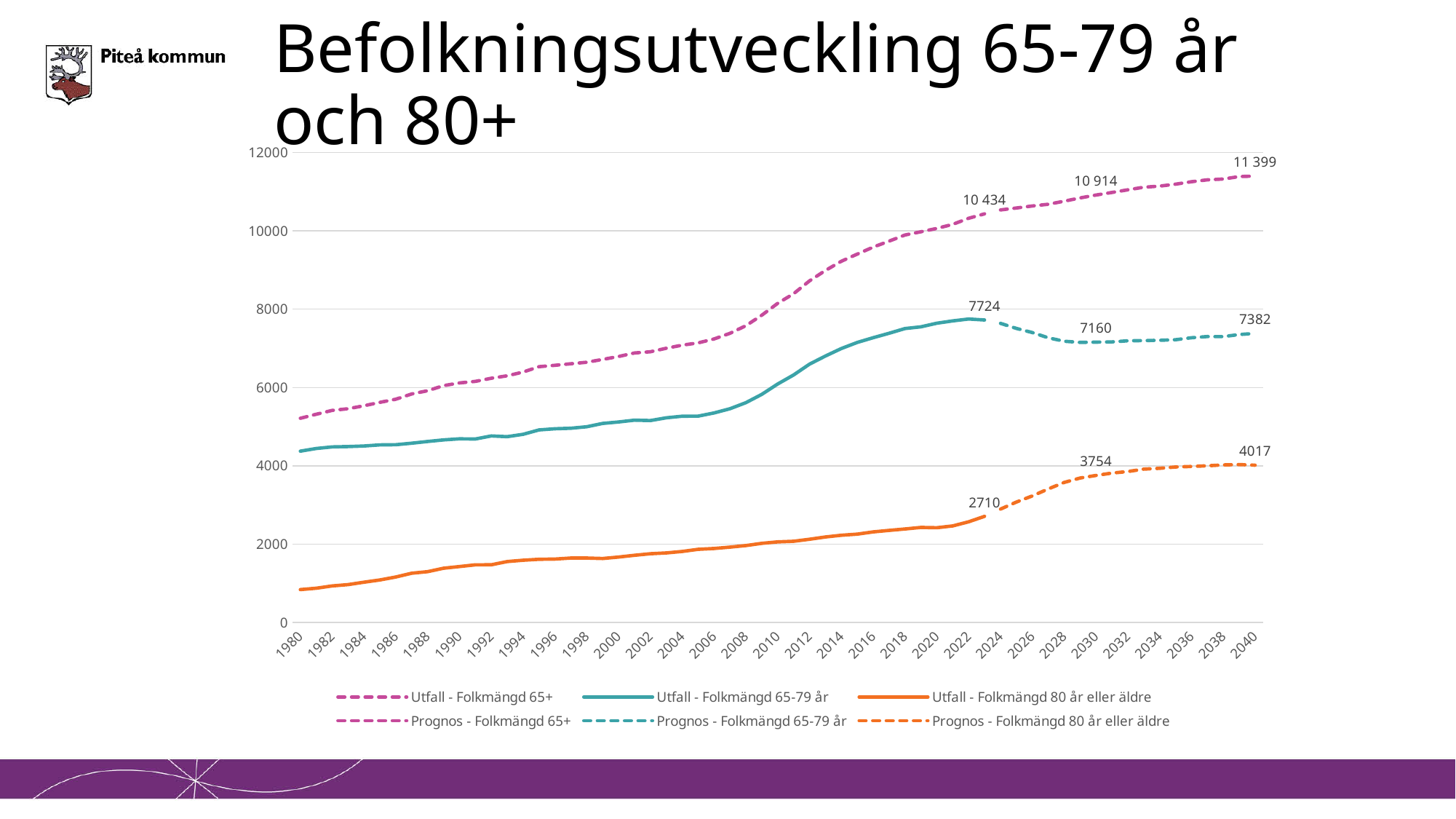
Does the Utfall - Folkmängd 65+ line rise or fall from 1980 to 2022? Rise What kind of chart is shown on the slide? Line chart Which is larger: the 2040 value of the Prognos - Folkmängd 65-79 år line or the 2040 value of the Prognos - Folkmängd 80 år eller äldre line? Prognos - Folkmängd 65-79 år How many series does the legend list? 6 What is the final labelled value (at 2040) of the Prognos - Folkmängd 65+ line? 11 399 What is the last labelled value of the Utfall - Folkmängd 65-79 år line, where it meets the prognosis? 7724 Is the value of the Utfall - Folkmängd 80 år eller äldre line in 1980 greater or less than 2000? less What is the difference between the first labelled value of the Prognos - Folkmängd 65+ line (10 434) and its final value at 2040 (11 399)? 965 What is the final labelled value (at 2040) of the Prognos - Folkmängd 80 år eller äldre line? 4017 What is the title of the chart on the slide? Befolkningsutveckling 65-79 år och 80+ What is the last labelled value of the Utfall - Folkmängd 80 år eller äldre line, where it meets the prognosis? 2710 What is the final labelled value (at 2040) of the Prognos - Folkmängd 65-79 år line? 7382